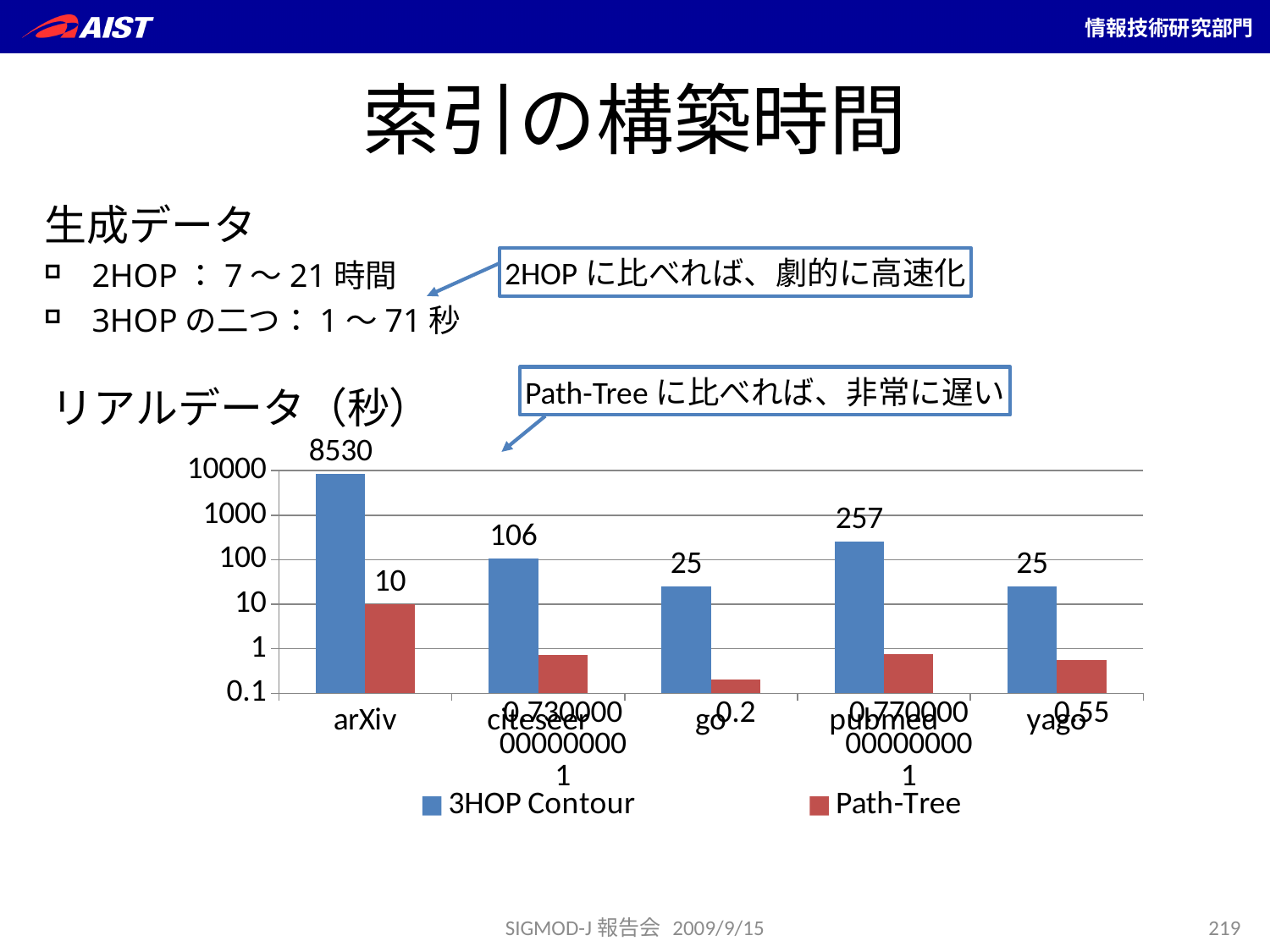
What is the 3HOP Contour value for pubmed? 257 What is the 3HOP Contour value for arXiv? 8530 Which has the larger 3HOP Contour value, citeseer or pubmed? pubmed What is the 3HOP Contour value for citeseer? 106 Is the Path-Tree value for citeseer greater or less than 10? less Which category has the highest 3HOP Contour value? arXiv How many series does the legend list? 2 What is the Path-Tree value for go? 0.2 What is the Path-Tree value for yago? 0.55 Which category has the lowest Path-Tree value? go What is the Path-Tree value for arXiv? 10 What is the difference between the 3HOP Contour and Path-Tree values for arXiv? 8520